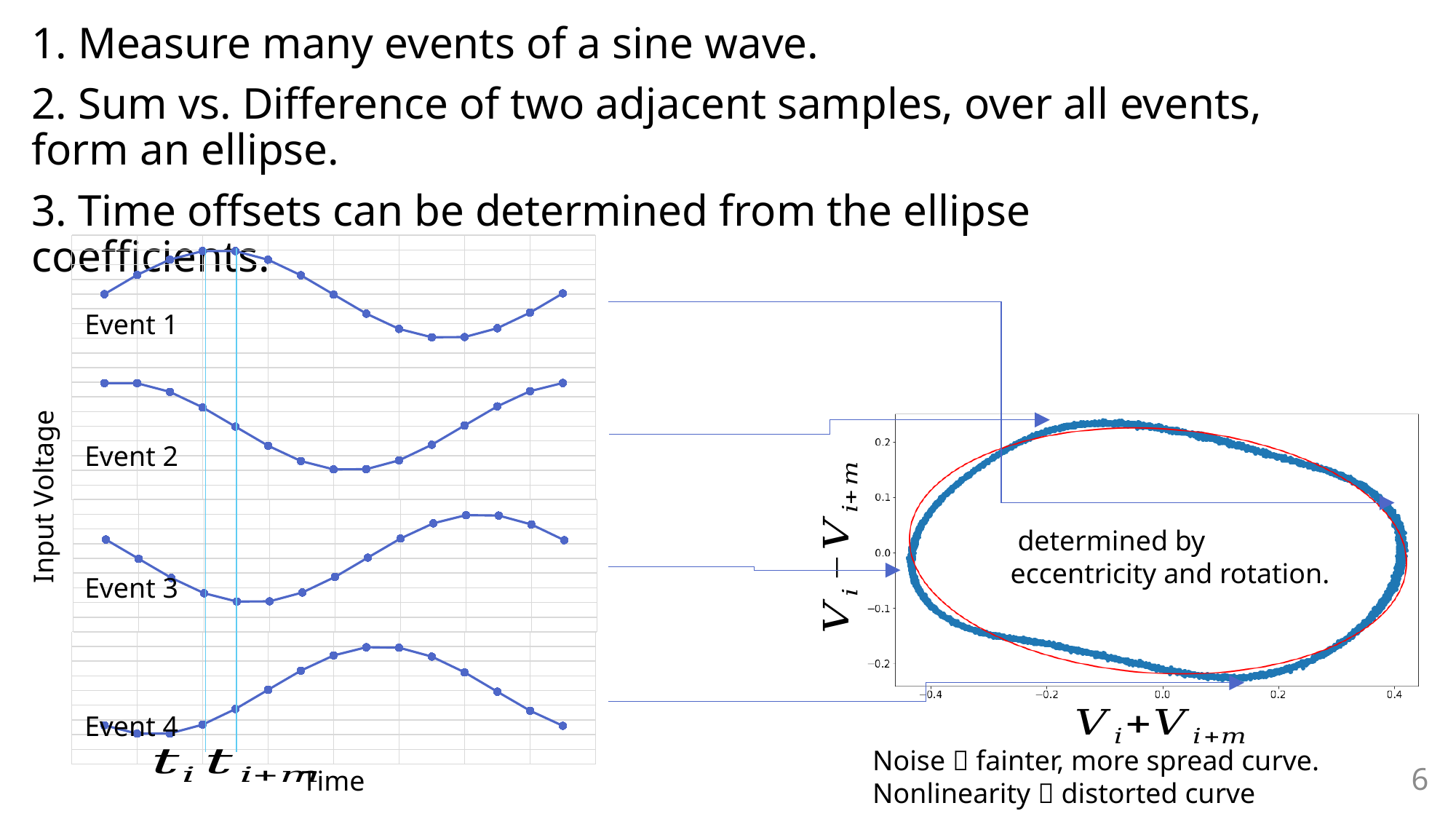
On the right chart, is the lowest vertical-axis value reached by the ellipse greater or less than -0.1? less What kind of chart is the left chart showing the four events? Line chart On the left chart, does Event 4 rise or fall between the first point and the peak near the middle of the time axis? Rise On the right chart, is the smallest horizontal-axis value reached by the ellipse greater or less than -0.2? less On the right chart, is the largest horizontal-axis value reached by the ellipse greater or less than 0.2? greater On the left chart, how many events are plotted? 4 On the right chart, what shape do the plotted points form? An ellipse On the left chart, what is the label of the horizontal axis? Time On the left chart, what is the label of the vertical axis? Input Voltage On the left chart, does Event 1 rise or fall from its peak near the left to the trough near the middle of the time axis? Fall On the right chart, what is the largest tick value shown on the horizontal axis? 0.4